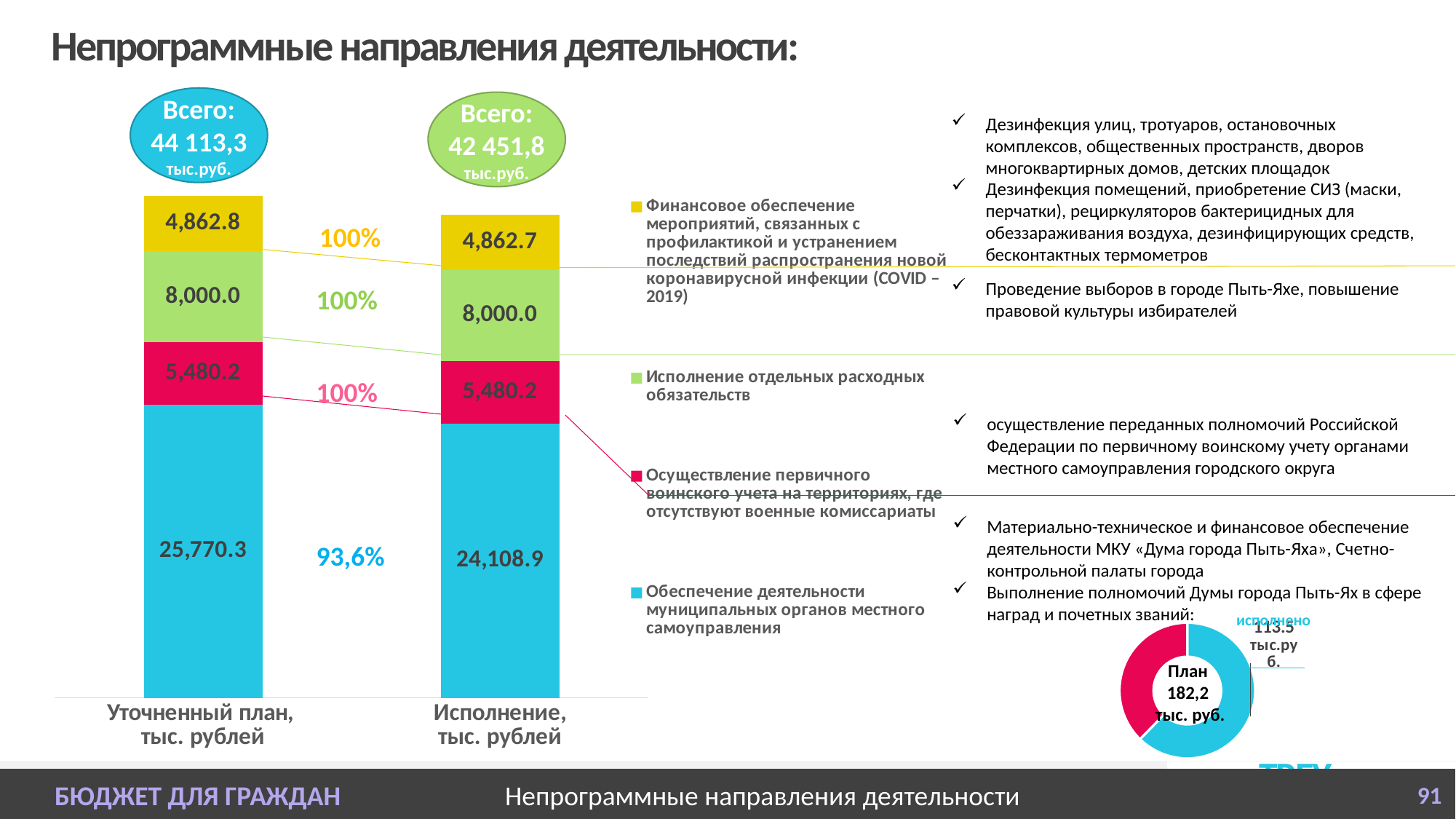
What is the total ('Всего') shown above the 'Исполнение, тыс. рублей' bar? 42 451,8 тыс.руб. In the stacked bar chart, what is the value for the COVID-2019 series ('Финансовое обеспечение мероприятий...') in the 'Исполнение, тыс. рублей' bar? 4,862.7 In the stacked bar chart, which series has the smallest segment in the 'Исполнение, тыс. рублей' bar? Финансовое обеспечение мероприятий, связанных с профилактикой и устранением последствий распространения новой коронавирусной инфекции (COVID – 2019) In the stacked bar chart, what is the value for 'Обеспечение деятельности муниципальных органов местного самоуправления' in the 'Уточненный план, тыс. рублей' bar? 25,770.3 In the stacked bar chart, which is larger in the 'Уточненный план' bar: 'Исполнение отдельных расходных обязательств' or 'Осуществление первичного воинского учета на территориях, где отсутствуют военные комиссариаты'? Исполнение отдельных расходных обязательств In the stacked bar chart, what is the difference between the 'Уточненный план' and 'Исполнение' values for 'Обеспечение деятельности муниципальных органов местного самоуправления'? 1,661.4 How many stacked bars does the main chart show? 2 In the stacked bar chart, what is the value for 'Обеспечение деятельности муниципальных органов местного самоуправления' in the 'Исполнение, тыс. рублей' bar? 24,108.9 In the stacked bar chart, which series has the largest segment in the 'Уточненный план, тыс. рублей' bar? Обеспечение деятельности муниципальных органов местного самоуправления What kind of chart is the main chart on the left of the slide? Stacked bar chart What is the total ('Всего') shown above the 'Уточненный план, тыс. рублей' bar? 44 113,3 тыс.руб. How many series does the legend of the stacked bar chart list? 4